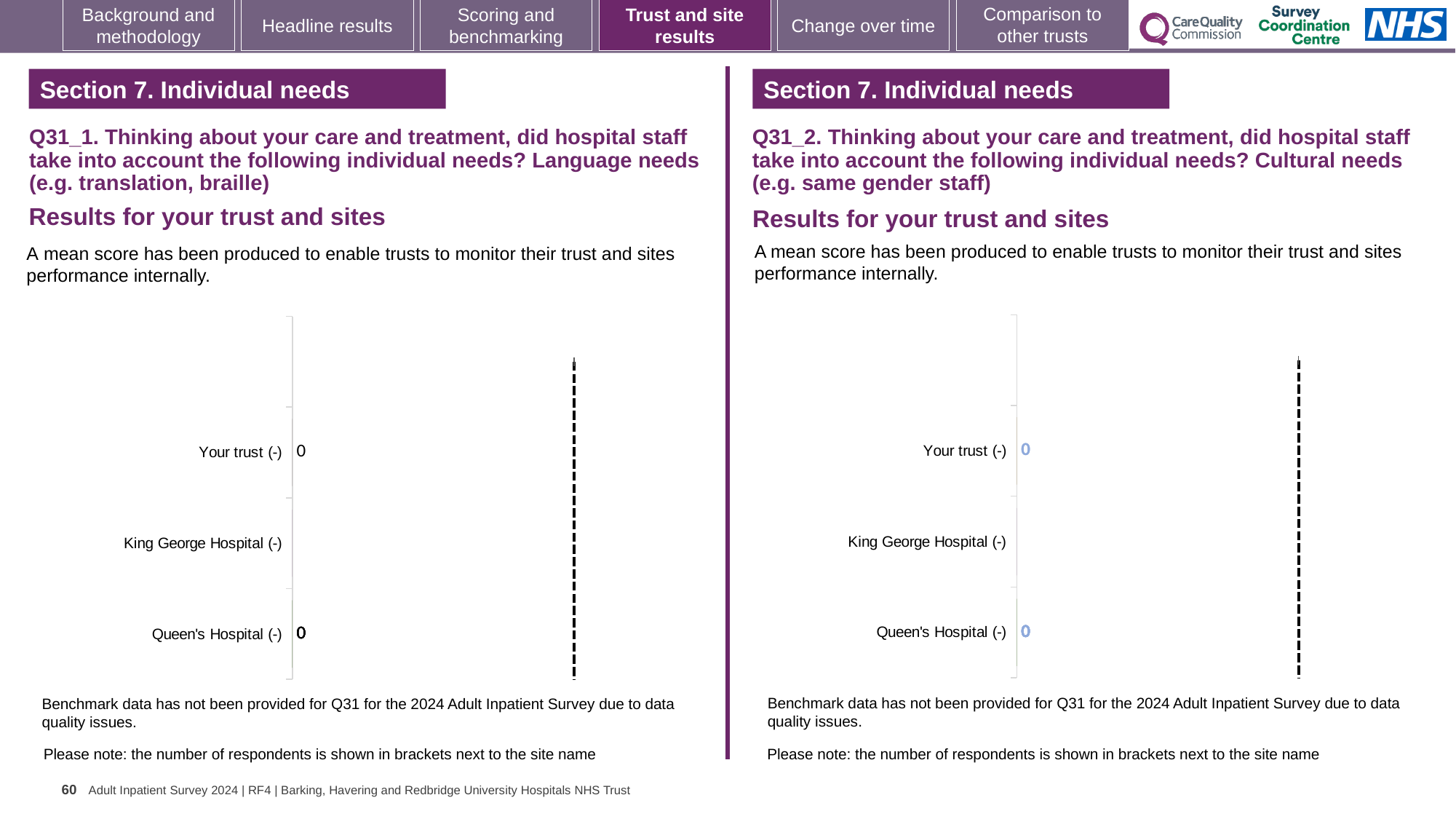
On the right chart (Q31_2, Cultural needs), what value is shown for Queen's Hospital (-)? 0 On the right chart (Q31_2, Cultural needs), what is the difference between the values for Your trust (-) and Queen's Hospital (-)? 0 On the right chart (Q31_2, Cultural needs), what value is shown for Your trust (-)? 0 On the left chart (Q31_1, Language needs), what value is shown for Queen's Hospital (-)? 0 On the right chart (Q31_2, Cultural needs), which category is listed first (at the top) on the vertical axis? Your trust (-) On the left chart (Q31_1, Language needs), what value is shown for Your trust (-)? 0 On the left chart (Q31_1, Language needs), how many categories are listed on the vertical axis? 3 On the left chart (Q31_1, Language needs), which category is listed in the middle of the vertical axis? King George Hospital (-) On the right chart (Q31_2, Cultural needs), how many categories are listed on the vertical axis? 3 On the left chart (Q31_1, Language needs), what is the difference between the values for Your trust (-) and Queen's Hospital (-)? 0